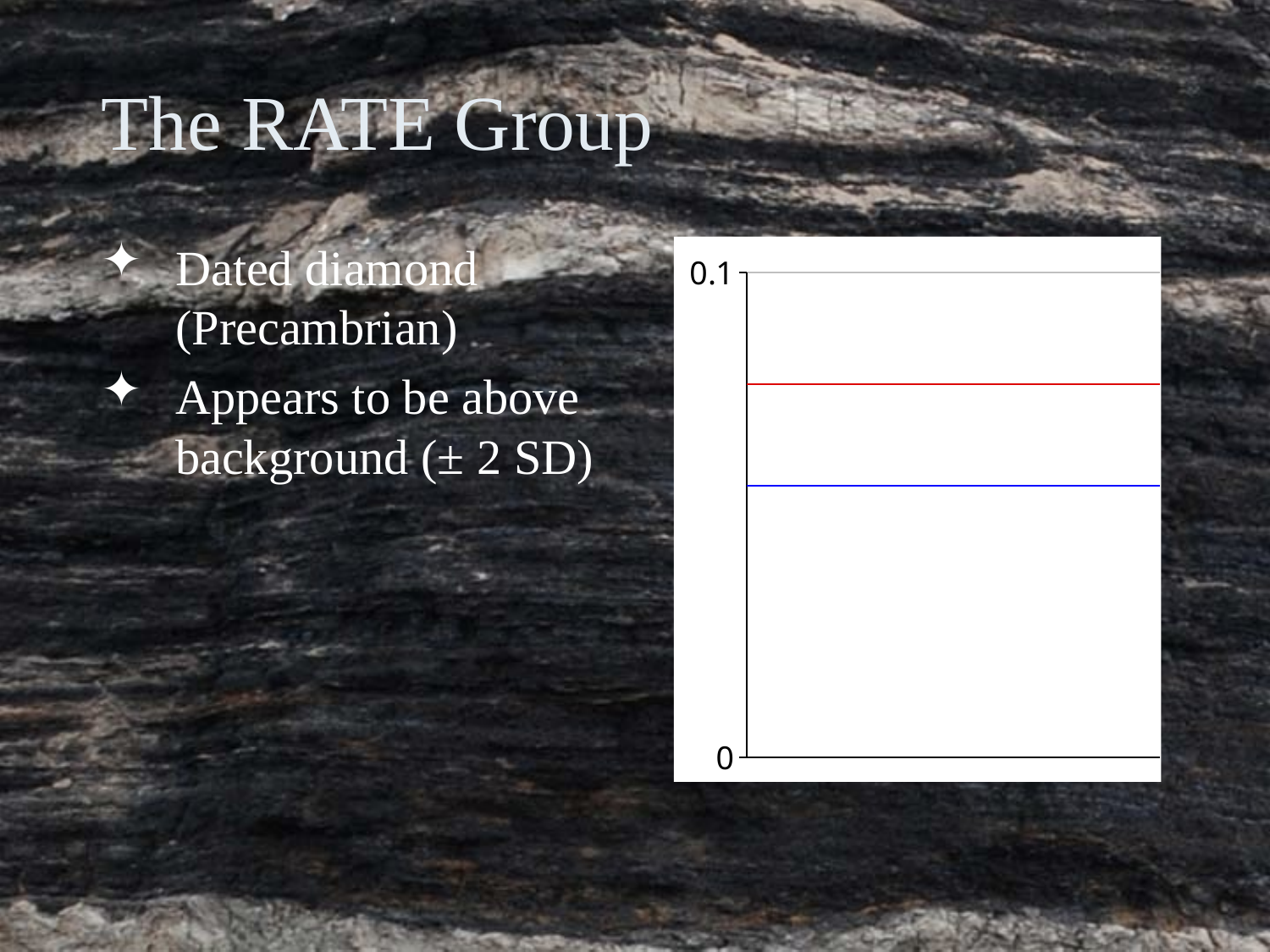
Which line is higher on the chart, the red line or the blue line? the red line Is the value of the blue line greater or less than 0.1? less Is the value of the blue line greater or less than 0? greater Is the value of the red line greater or less than 0.1? less What is the highest value labelled on the y axis of the chart? 0.1 What colours are the two lines on the chart? red and blue How many lines are plotted on the chart? 2 What kind of chart is shown on the slide? line chart Do the plotted lines rise, fall, or stay flat along the x axis? stay flat